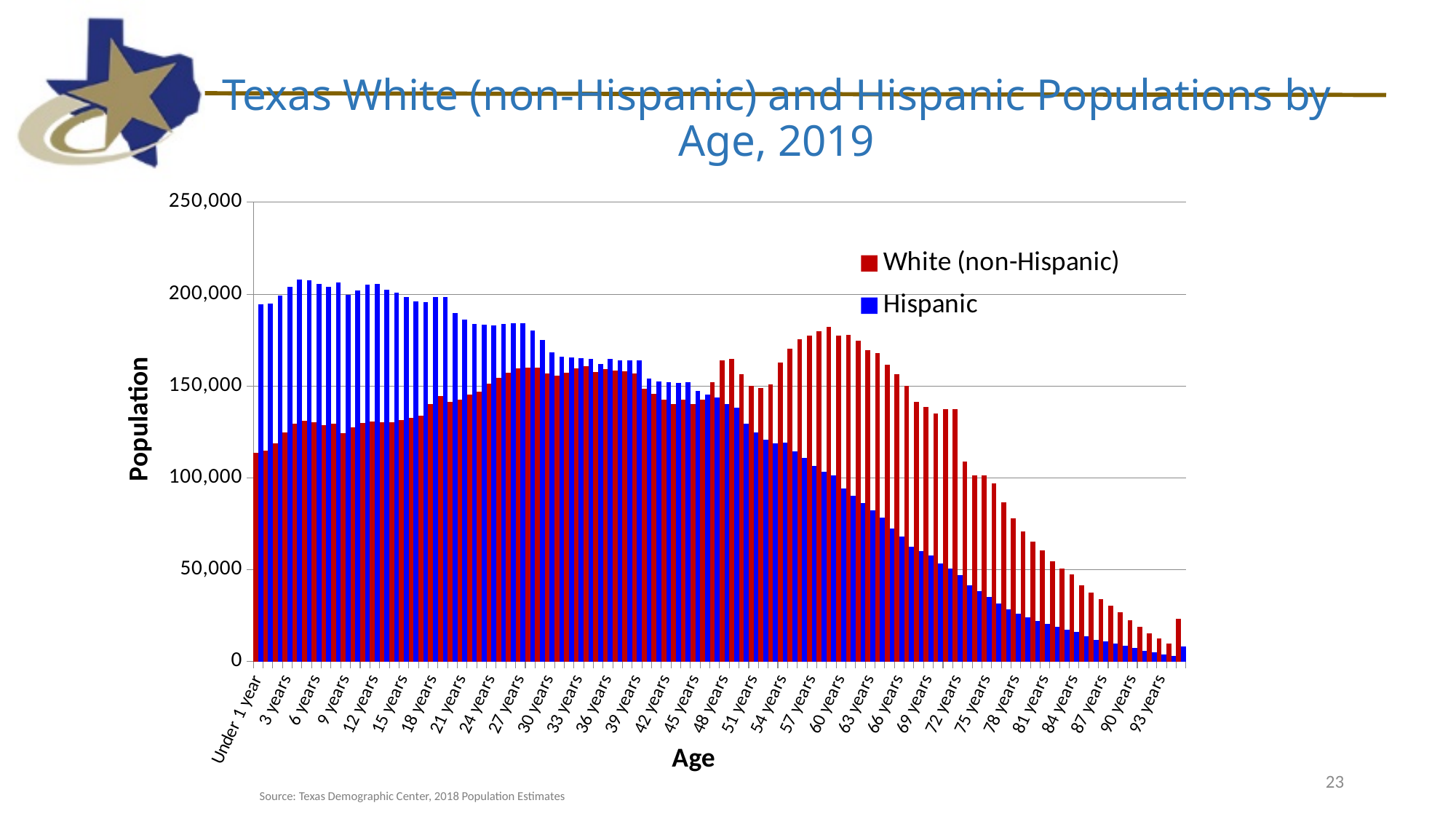
At 60 years, which series has the larger value, White (non-Hispanic) or Hispanic? White (non-Hispanic) Is the Hispanic value for 6 years greater or less than 200,000? greater Is the Hispanic value for Under 1 year greater or less than 150,000? greater What kind of chart is shown on the slide? bar chart Do the White (non-Hispanic) values generally rise or fall from 60 years to 93 years? fall Is the Hispanic value for 60 years greater or less than 100,000? less Which colour represents the Hispanic series in the chart? blue What is the label of the vertical axis? Population How many series does the legend list? 2 At 6 years, which series has the larger value, White (non-Hispanic) or Hispanic? Hispanic